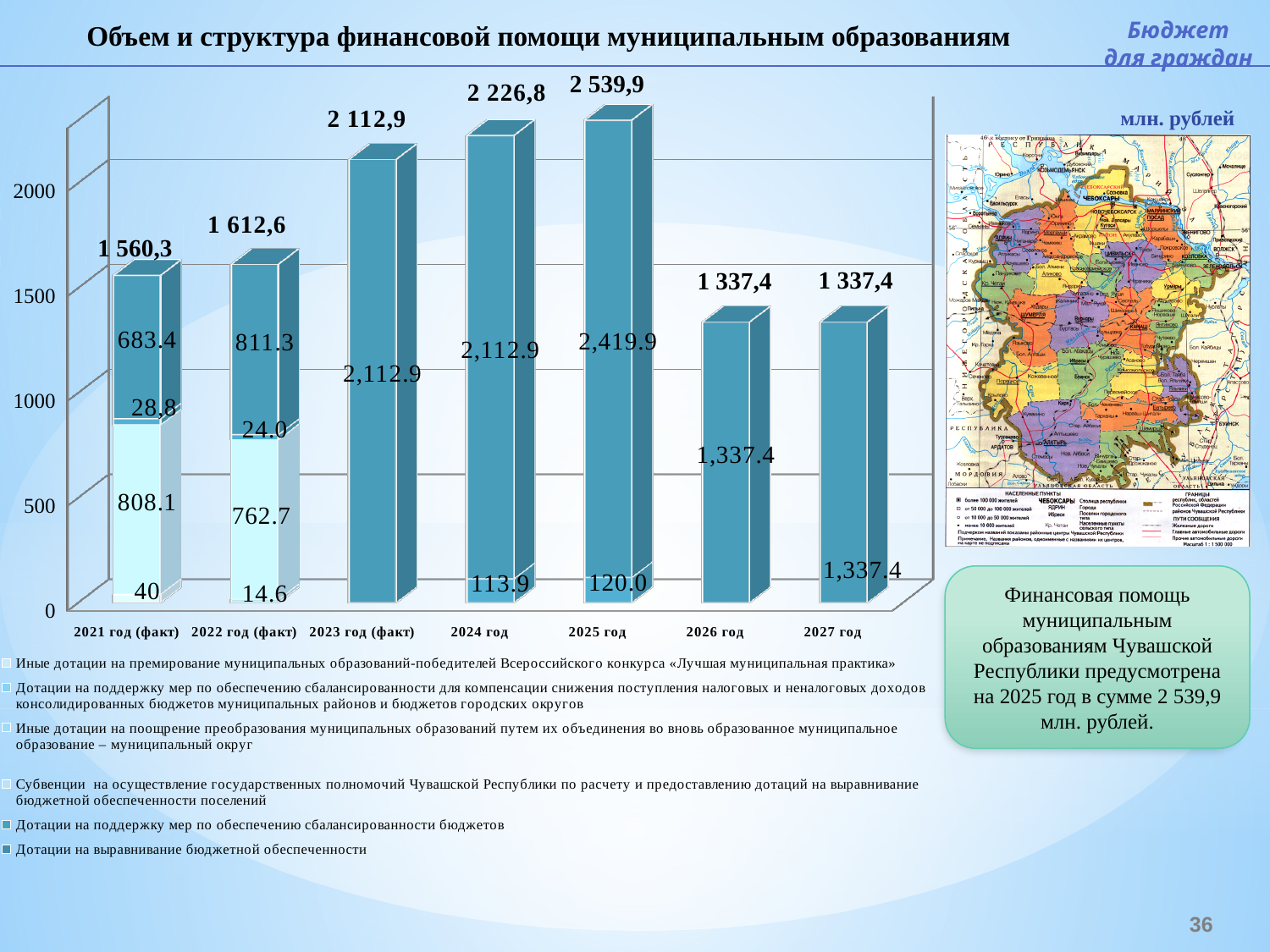
What is the total value labelled above the bar for 2023 год (факт)? 2 112,9 Is the total for 2026 год greater or less than 1500? less What is the total value labelled above the bar for 2021 год (факт)? 1 560,3 Do the totals rise or fall from 2021 год (факт) to 2025 год? rise Which total is larger, 2021 год (факт) or 2022 год (факт)? 2022 год (факт) How many series does the legend list? 6 What is the total financial aid shown above the bar for 2025 год? 2 539,9 Which year has the highest total financial aid in the chart? 2025 год What is the difference between the totals for 2023 год (факт) and 2022 год (факт)? 500,3 How many years (categories) are shown on the x axis of the chart? 7 What kind of chart is shown on the slide? bar chart What is the difference between the totals for 2025 год and 2024 год? 313,1